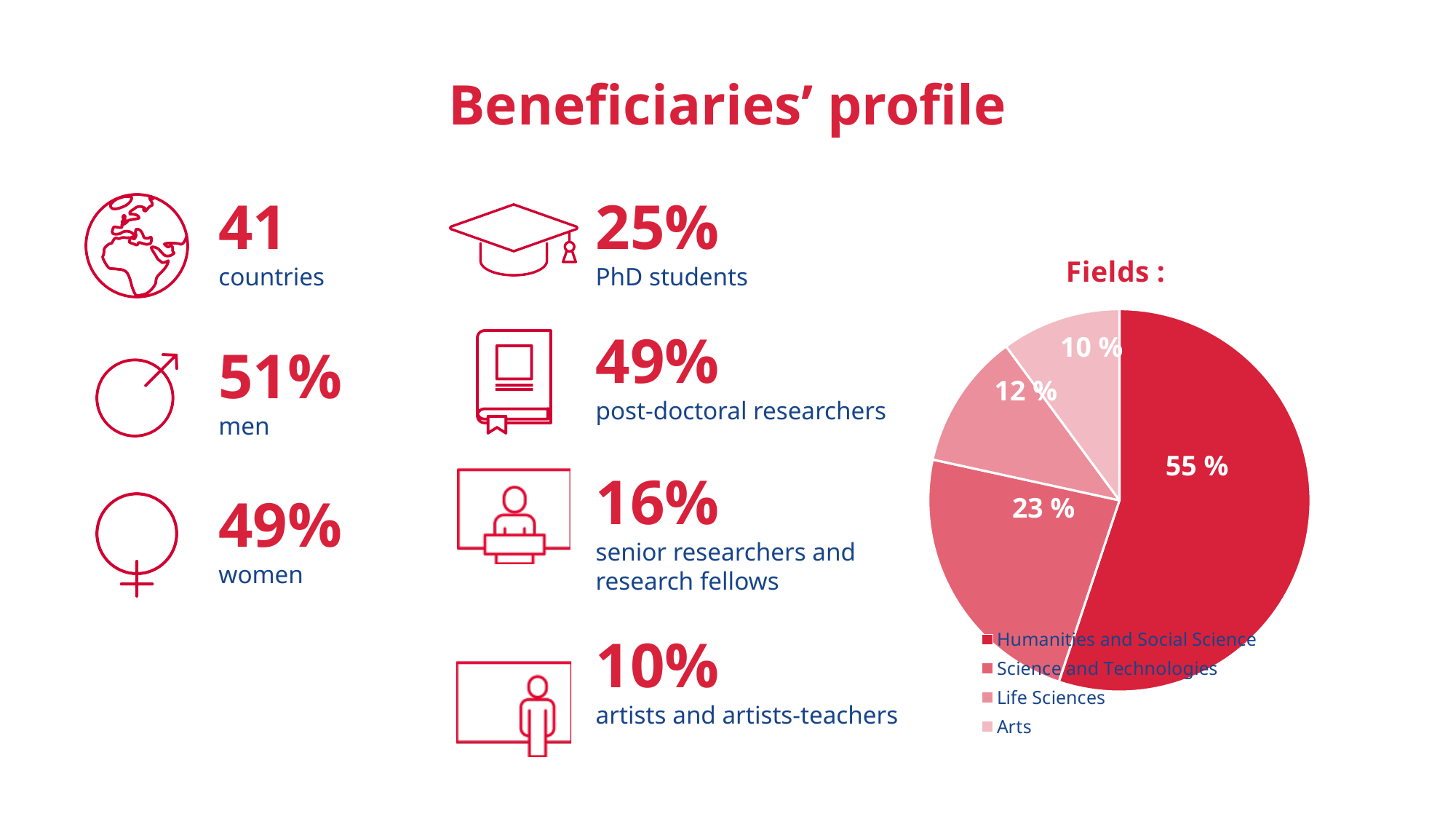
In the Fields pie chart, what share is shown for Humanities and Social Science? 55 % What is the title shown above the pie chart? Fields : In the Fields pie chart, how many percentage points larger is Humanities and Social Science than Science and Technologies? 32 What kind of chart is shown under the heading "Fields :"? pie chart In the Fields pie chart, what share is shown for Science and Technologies? 23 % Which field has the largest slice in the Fields pie chart? Humanities and Social Science How many slices does the Fields pie chart have? 4 In the Fields pie chart, what share is shown for Arts? 10 % In the Fields pie chart, what share is shown for Life Sciences? 12 % In the Fields pie chart, which is larger: Life Sciences or Science and Technologies? Science and Technologies How many entries does the legend of the Fields pie chart list? 4 Which field has the smallest slice in the Fields pie chart? Arts